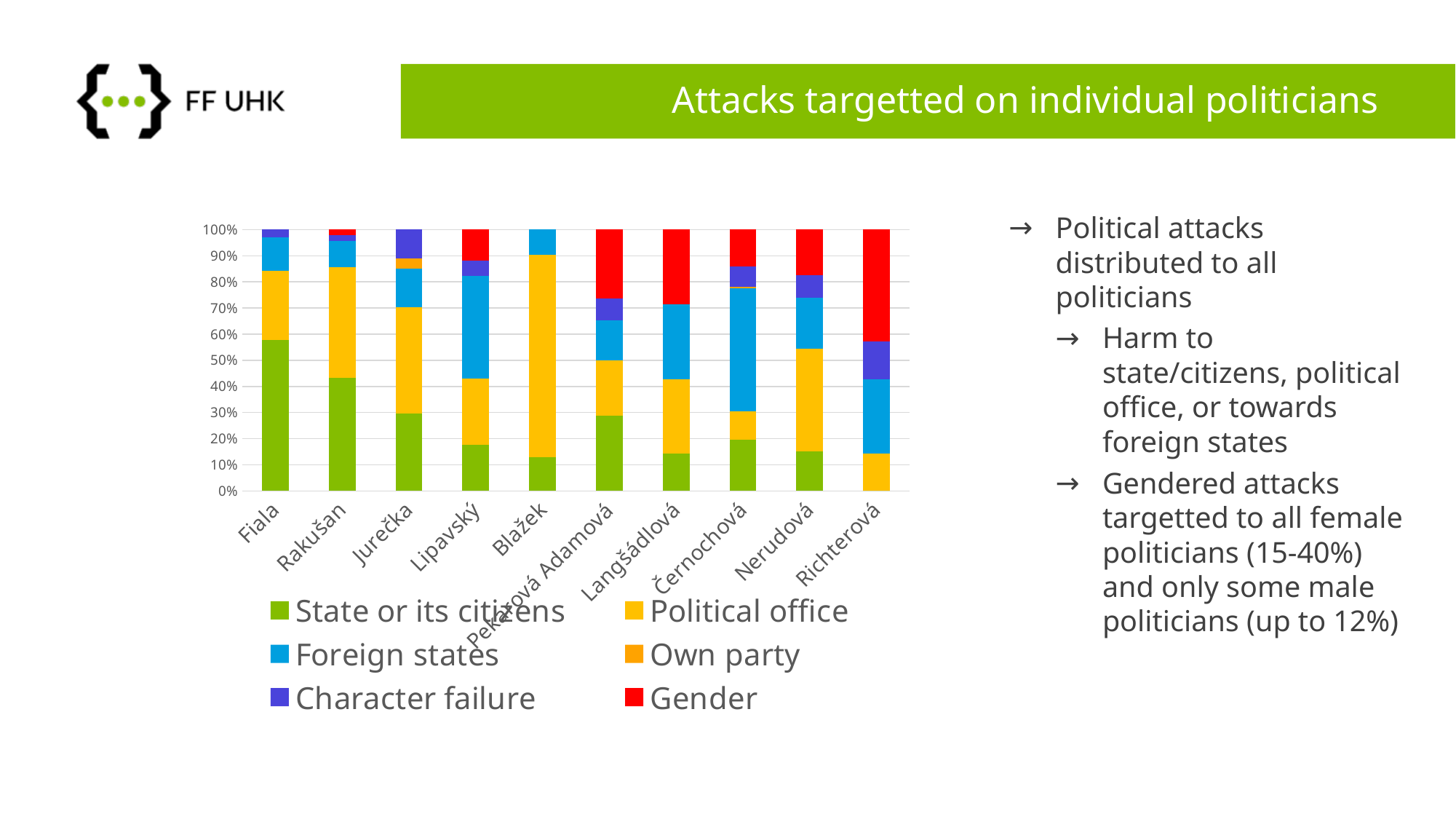
Is the 'Gender' share for Richterová greater or less than 30%? greater What is the title of the chart slide? Attacks targetted on individual politicians Which politician has the largest 'Gender' share? Richterová How many politicians are shown on the x axis of the chart? 10 How many series does the chart legend list? 6 Is the 'Political office' share for Blažek greater or less than 70%? greater Is the 'State or its citizens' share for Rakušan greater or less than 50%? less Which legend entry is shown in red? Gender Which politician has the largest 'State or its citizens' share? Fiala Which politician has the larger 'Gender' share, Pekarová Adamová or Černochová? Pekarová Adamová What kind of chart is shown on the slide? Stacked bar chart